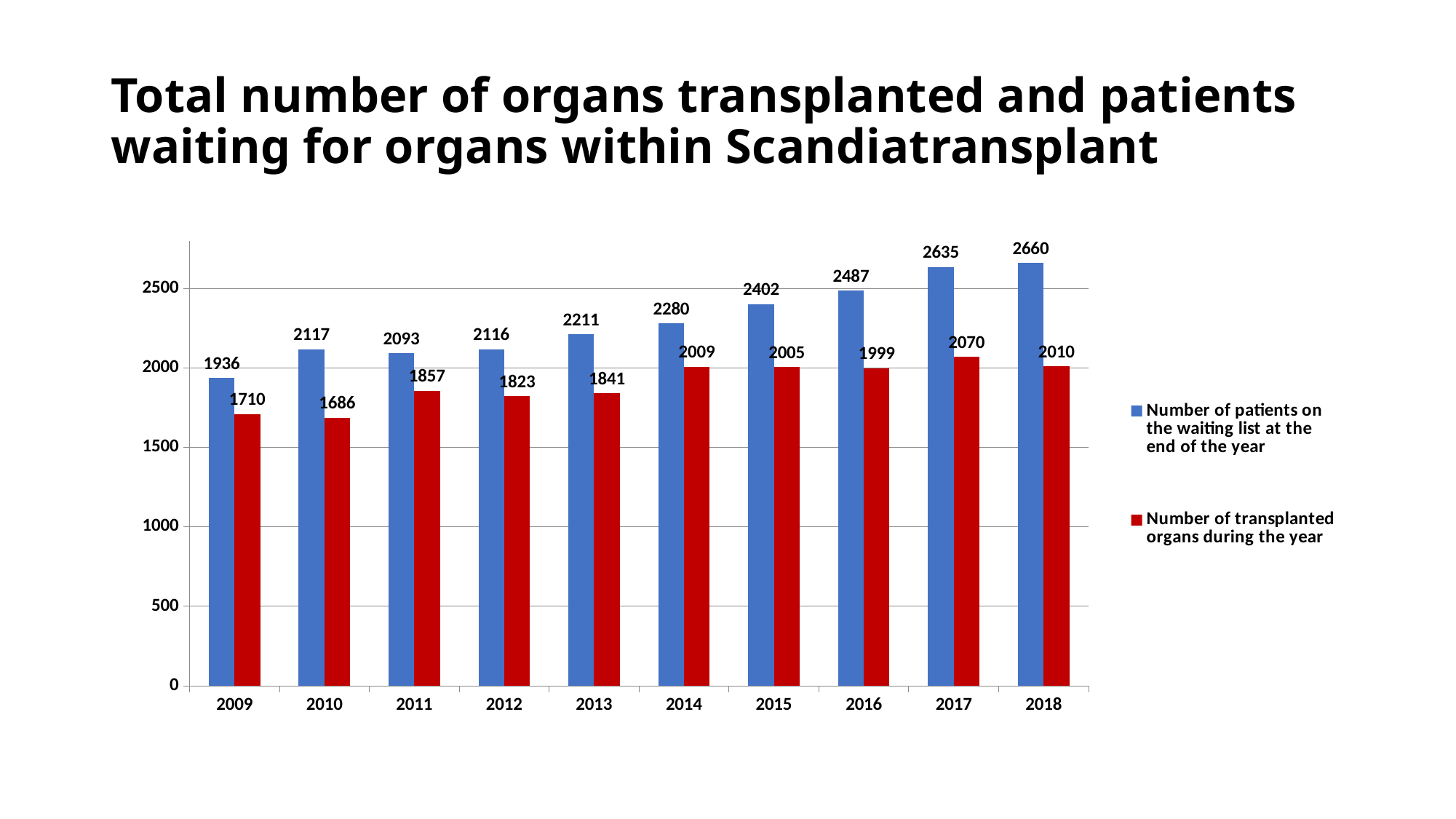
Is the number of transplanted organs during the year in 2009 greater or less than 2000? less Which colour represents the number of transplanted organs during the year? Red How many years are shown on the x axis? 10 Which is larger in 2013: the number of patients on the waiting list at the end of the year or the number of transplanted organs during the year? Number of patients on the waiting list at the end of the year Does the number of patients on the waiting list at the end of the year rise or fall from 2013 to 2018? Rise In which year was the number of patients on the waiting list at the end of the year highest? 2018 What kind of chart is shown on the slide? Bar chart In which year was the number of transplanted organs during the year lowest? 2010 What was the number of patients on the waiting list at the end of the year in 2014? 2280 How many series does the legend list? 2 What was the number of transplanted organs during the year in 2011? 1857 What is the difference between the number of patients on the waiting list and the number of transplanted organs in 2018? 650